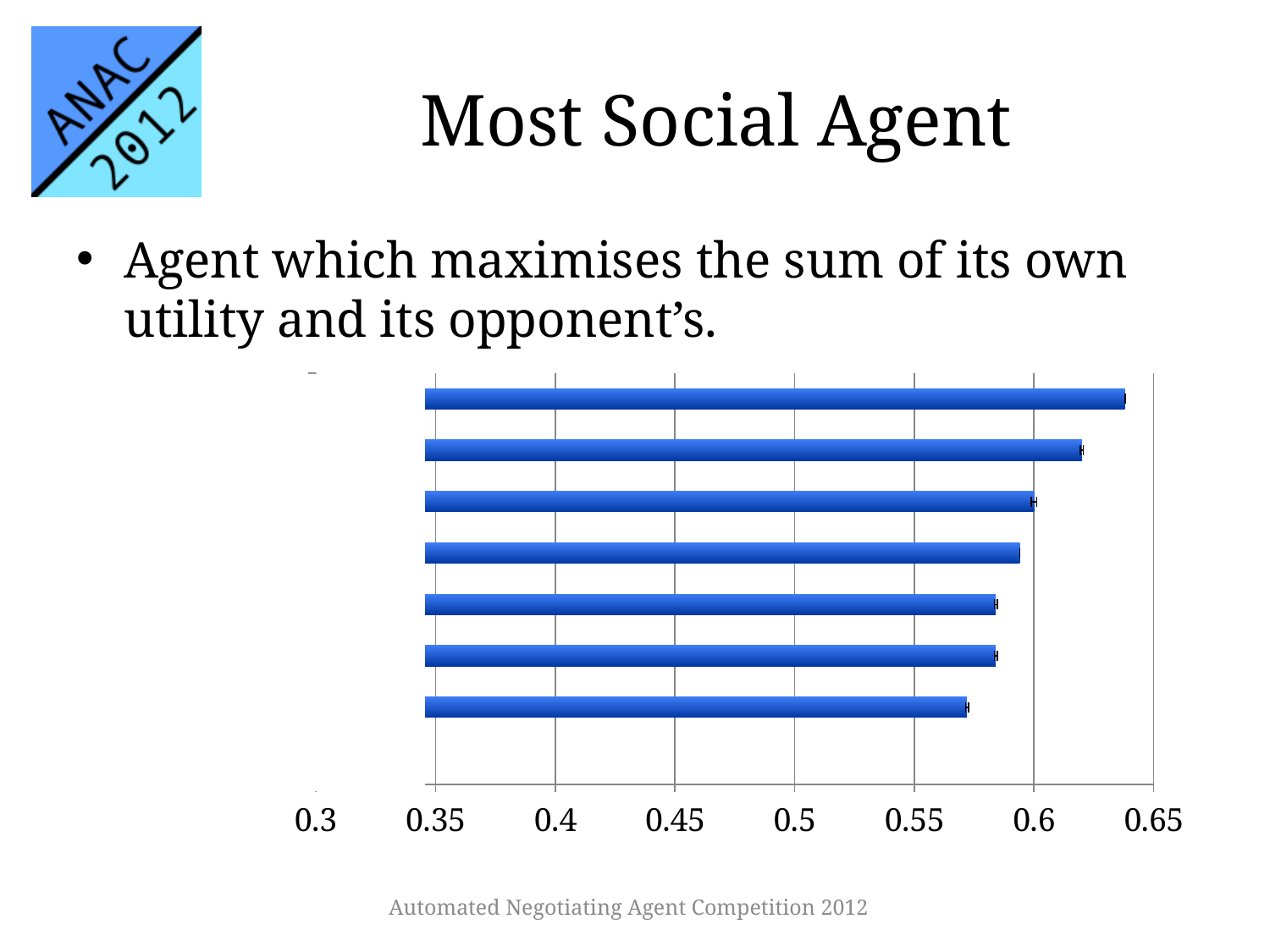
Which bar is the shortest in the chart? the bottom bar What kind of chart is shown on the slide? bar chart Is the value of the second bar from the top greater or less than 0.6? greater Is the value of the bottom bar greater or less than 0.6? less What is the highest tick label shown on the horizontal axis? 0.65 Is the value of the bottom bar greater or less than 0.55? greater Which bar is the longest in the chart? the top bar Do the bar values increase or decrease going from the top bar to the bottom bar? decrease Which is larger, the value of the top bar or the value of the bottom bar? the top bar How many bars are plotted in the chart? 7